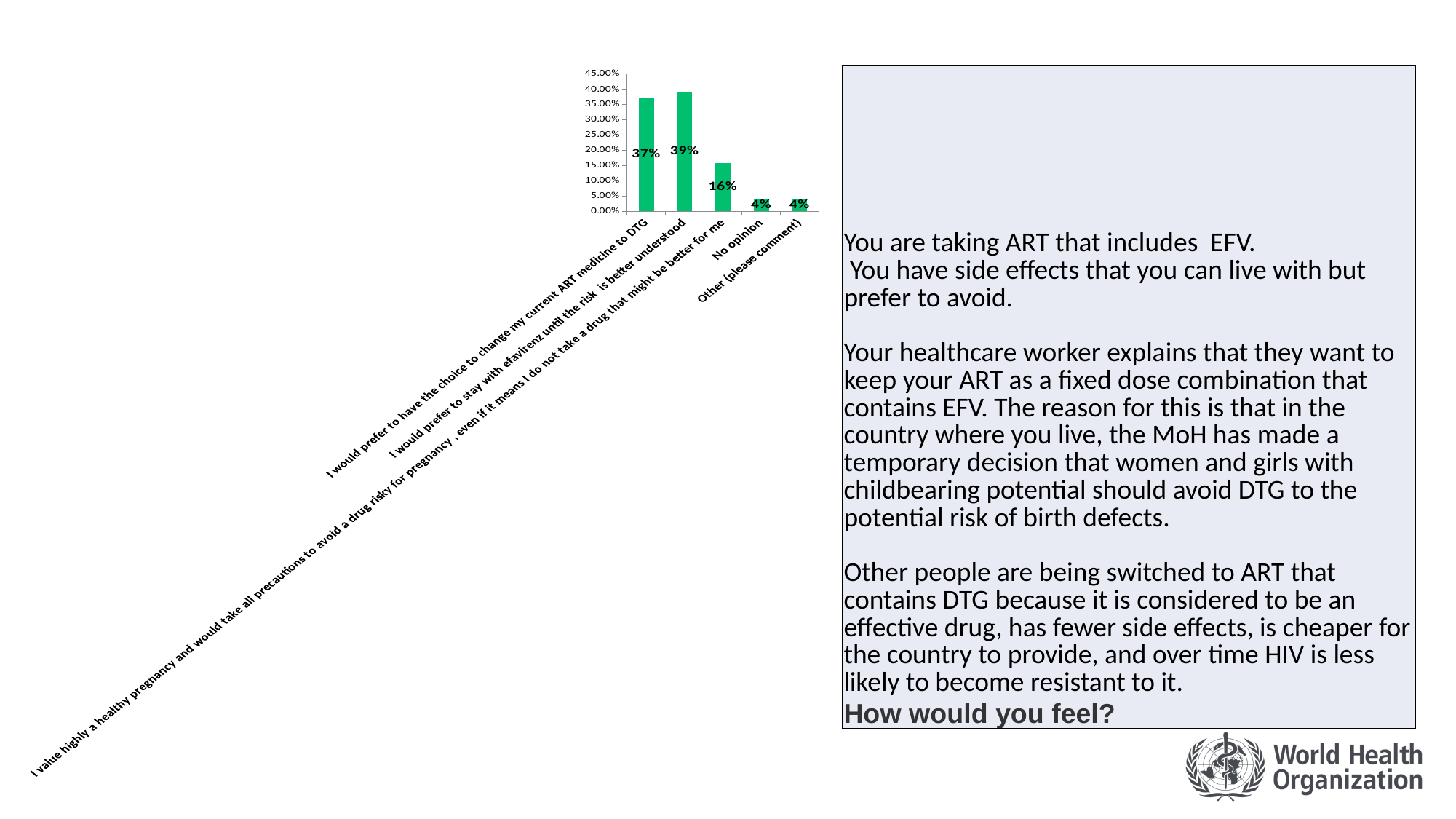
What is the value shown for 'No opinion'? 4% What percentage of respondents said they would prefer to have the choice to change their current ART medicine to DTG? 37% What percentage of respondents said they would prefer to stay with efavirenz until the risk is better understood? 39% What type of chart is shown on the slide? Bar chart Which response option has the highest percentage? I would prefer to stay with efavirenz until the risk is better understood What is the difference between the 37% bar and the 16% bar? 21 percentage points What is the value shown for 'Other (please comment)'? 4% How many response categories are shown on the chart? 5 What is the maximum value shown on the chart's vertical axis? 45.00% What is the difference in percentage points between 'I would prefer to stay with efavirenz until the risk is better understood' and 'I would prefer to have the choice to change my current ART medicine to DTG'? 2 percentage points Is the value for the response about valuing a healthy pregnancy greater or less than 20%? less Which is larger: the value for 'I would prefer to have the choice to change my current ART medicine to DTG' or the value for 'No opinion'? I would prefer to have the choice to change my current ART medicine to DTG